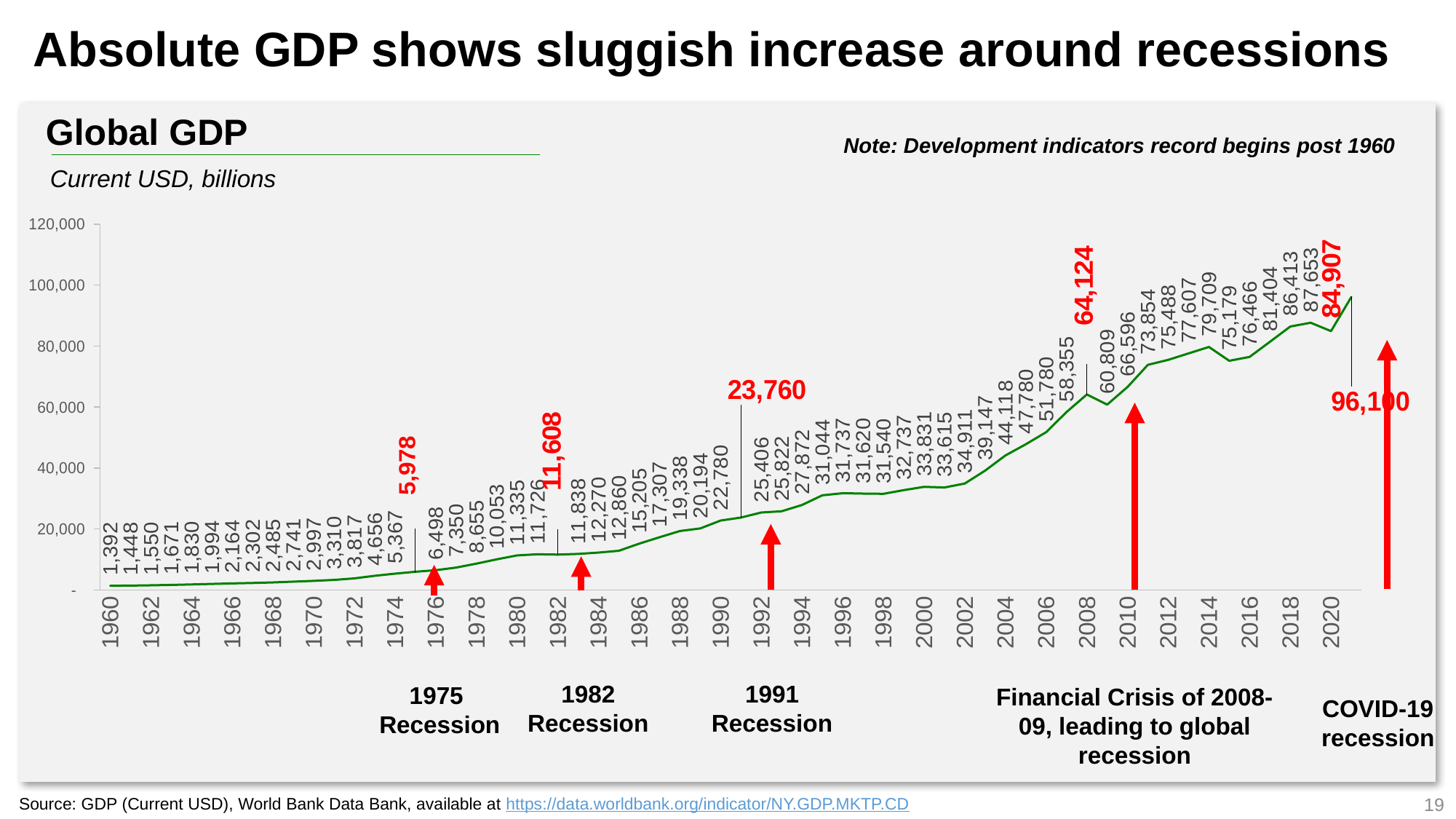
Which year has the highest Global GDP value on the chart? 2021 What is the Global GDP value for 1975? 5,978 What is the Global GDP value for 2020? 84,907 Which year has the lowest Global GDP value on the chart? 1960 What is the difference between the Global GDP values for 2021 and 2020? 11,193 What is the difference between the Global GDP values for 2008 and 2009? 3,315 What unit is Global GDP measured in on the chart? Current USD, billions What kind of chart is used to show Global GDP? line chart Is the Global GDP value for 2010 greater or less than 60,000? greater What is the Global GDP value for 2008? 64,124 What is the Global GDP value for 1960? 1,392 Which year has the larger Global GDP value, 2014 or 2015? 2014